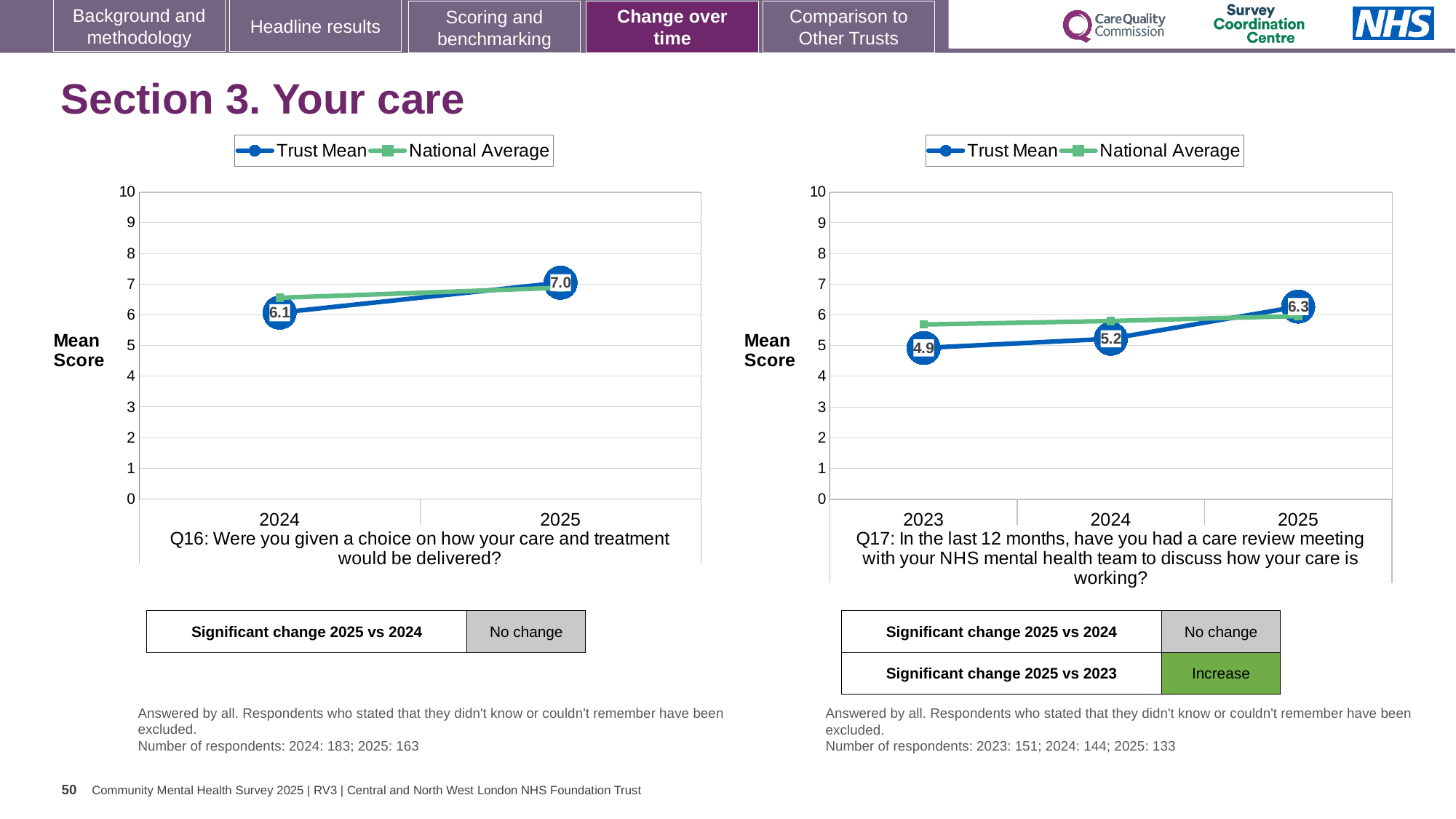
How many years are plotted on the x axis of the Q17 chart on the right? 3 In the Q16 chart on the left, what is the Trust Mean score for 2025? 7.0 What type of chart is used for Q16 on the left? Line chart In the Q16 chart on the left, by how much did the Trust Mean change from 2024 to 2025? 0.9 In the Q17 chart on the right, does the Trust Mean rise or fall from 2023 to 2025? Rise In the Q17 chart on the right, is the National Average for 2023 greater or less than 5? greater In the Q17 chart on the right, what is the difference between the Trust Mean scores for 2025 and 2024? 1.1 How many series does the legend of the Q16 chart on the left list? 2 In the Q17 chart on the right, which year has the lowest Trust Mean score? 2023 In the Q17 chart on the right, what is the Trust Mean score for 2023? 4.9 In the Q17 chart on the right, what is the Trust Mean score for 2025? 6.3 In the Q16 chart on the left, what is the Trust Mean score for 2024? 6.1